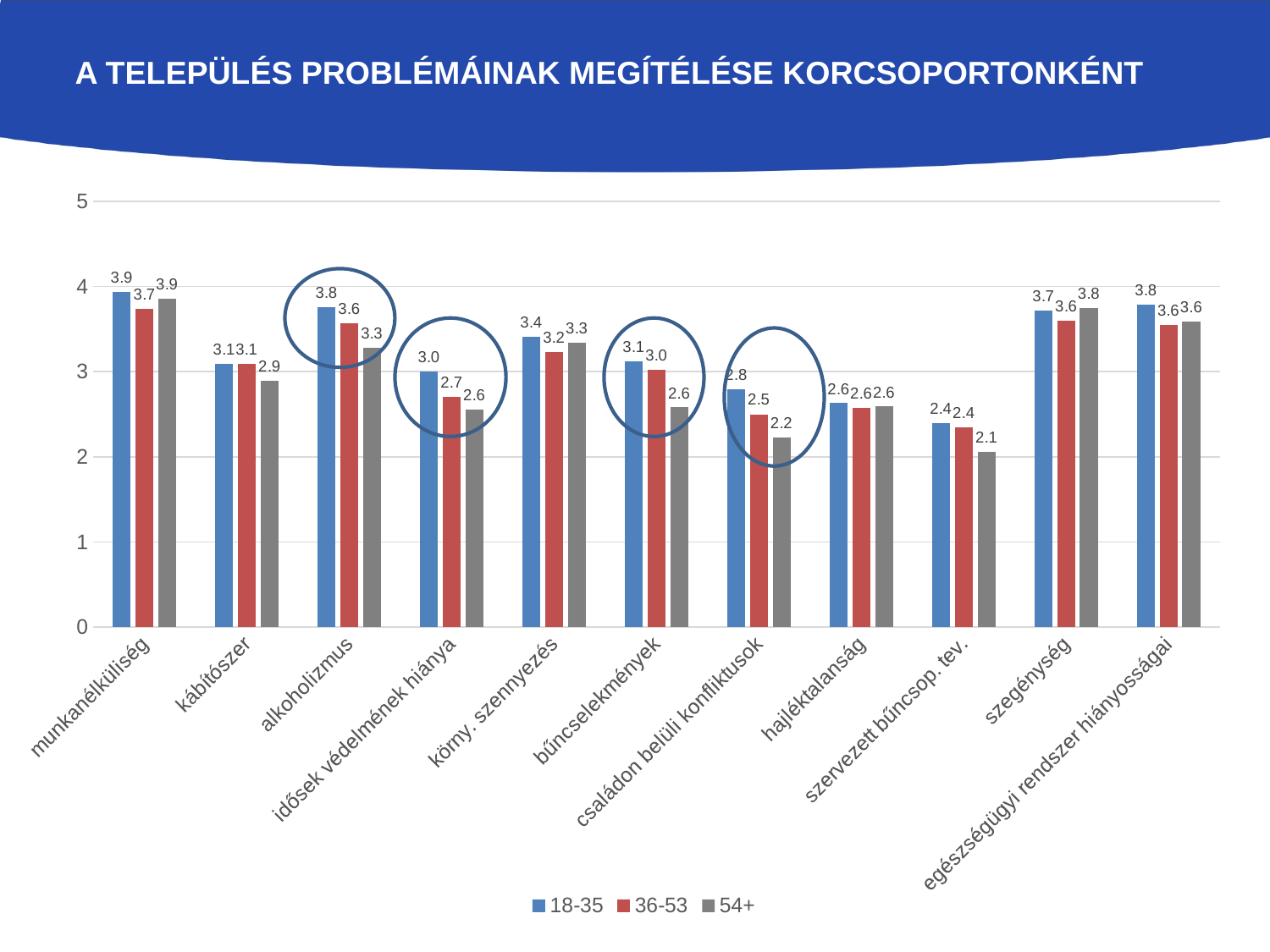
For alkoholizmus, which age group has the larger value: 36-53 or 54+? 36-53 Which category has the highest value for the 18-35 age group? munkanélküliség What is the value for the 18-35 age group for alkoholizmus? 3.8 What is the value for the 54+ age group for családon belüli konfliktusok? 2.2 How many categories are shown on the x axis? 11 Which age group is represented by the red bars? 36-53 For szegénység, which age group has the larger value: 18-35 or 54+? 54+ Which category has the lowest value for the 54+ age group? szervezett bűncsop. tev. How many series does the legend list? 3 What is the difference between the 18-35 and 54+ values for bűncselekmények? 0.5 What kind of chart is shown on the slide? bar chart What is the value for the 36-53 age group for idősek védelmének hiánya? 2.7